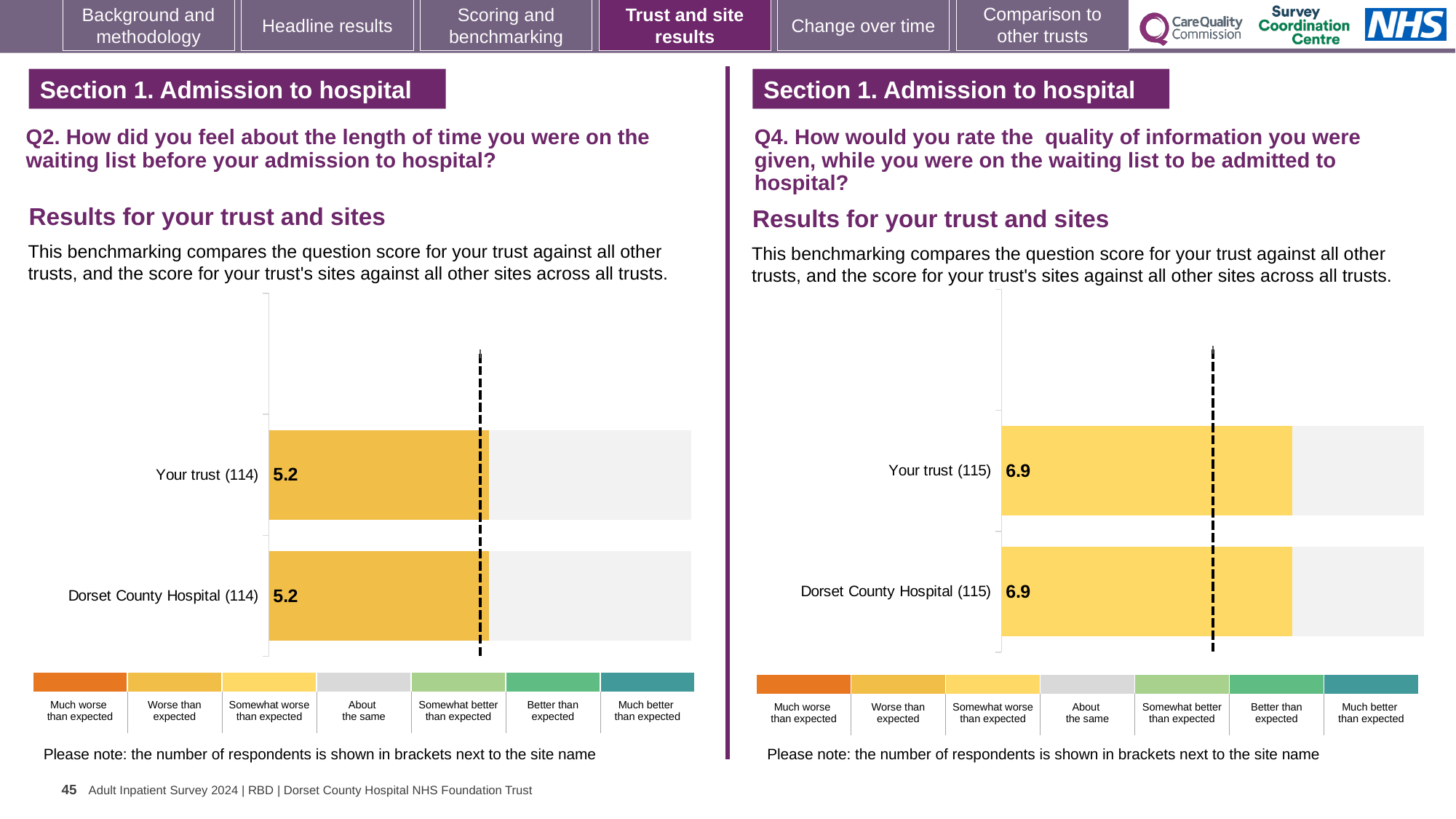
On the right chart (Q4), what is the score for Your trust? 6.9 On the left chart (Q2), what is the score for Your trust? 5.2 What kind of chart is used on the left (Q2)? Bar chart On the right chart (Q4), what is the difference between the score for Your trust and the score for Dorset County Hospital? 0 On the right chart (Q4), what is the score for Dorset County Hospital? 6.9 On the left chart (Q2), how many respondents are shown in brackets next to Your trust? 114 On the right chart (Q4), how many respondents are shown in brackets next to Dorset County Hospital? 115 How many bars are plotted on the left chart (Q2)? 2 How many bars are plotted on the right chart (Q4)? 2 On the left chart (Q2), what is the score for Dorset County Hospital? 5.2 Is the score for Your trust on the right chart (Q4) larger or smaller than the score for Your trust on the left chart (Q2)? Larger On the left chart (Q2), what is the difference between the score for Your trust and the score for Dorset County Hospital? 0